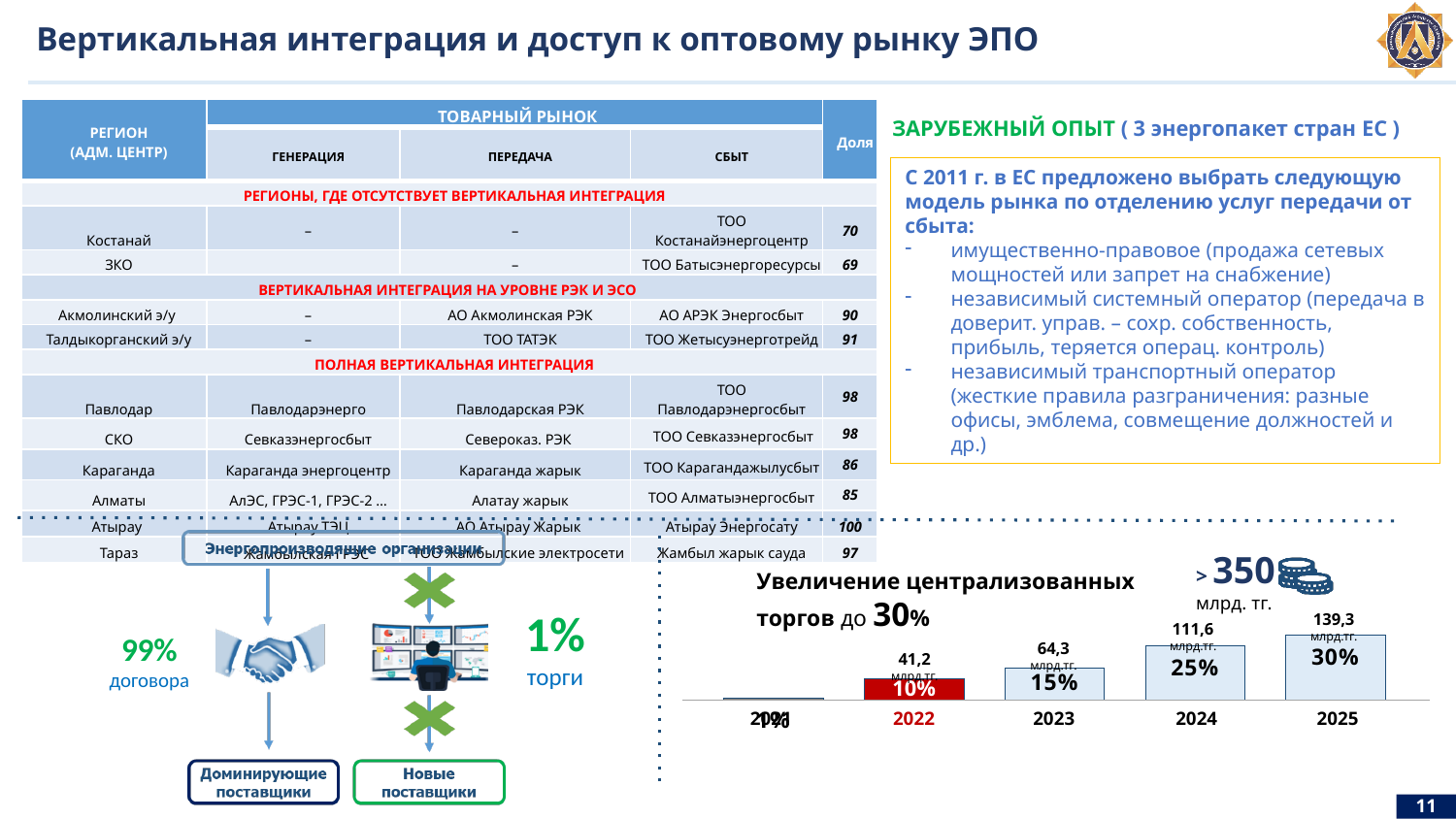
In the bar chart 'Увеличение централизованных торгов до 30%', what value in млрд.тг. is shown for 2022? 41,2 In the bar chart 'Увеличение централизованных торгов до 30%', do the values rise or fall from 2022 to 2025? rise In the bar chart 'Увеличение централизованных торгов до 30%', what is the difference in млрд.тг. between 2023 and 2022? 23,1 In the bar chart 'Увеличение централизованных торгов до 30%', what is the difference in млрд.тг. between 2025 and 2024? 27,7 In the bar chart 'Увеличение централизованных торгов до 30%', what percentage is shown for 2023? 15% What value is shown in the annotation above the 2025 bar in the bar chart 'Увеличение централизованных торгов до 30%'? > 350 млрд. тг. What kind of chart is 'Увеличение централизованных торгов до 30%'? bar chart What is the title of the chart in the bottom right of the slide? Увеличение централизованных торгов до 30% In the bar chart 'Увеличение централизованных торгов до 30%', what value in млрд.тг. is shown for 2024? 111,6 In the bar chart 'Увеличение централизованных торгов до 30%', which year has the highest value? 2025 In the bar chart 'Увеличение централизованных торгов до 30%', what percentage is shown for 2025? 30% In the bar chart 'Увеличение централизованных торгов до 30%', which year has the larger value, 2023 or 2024? 2024